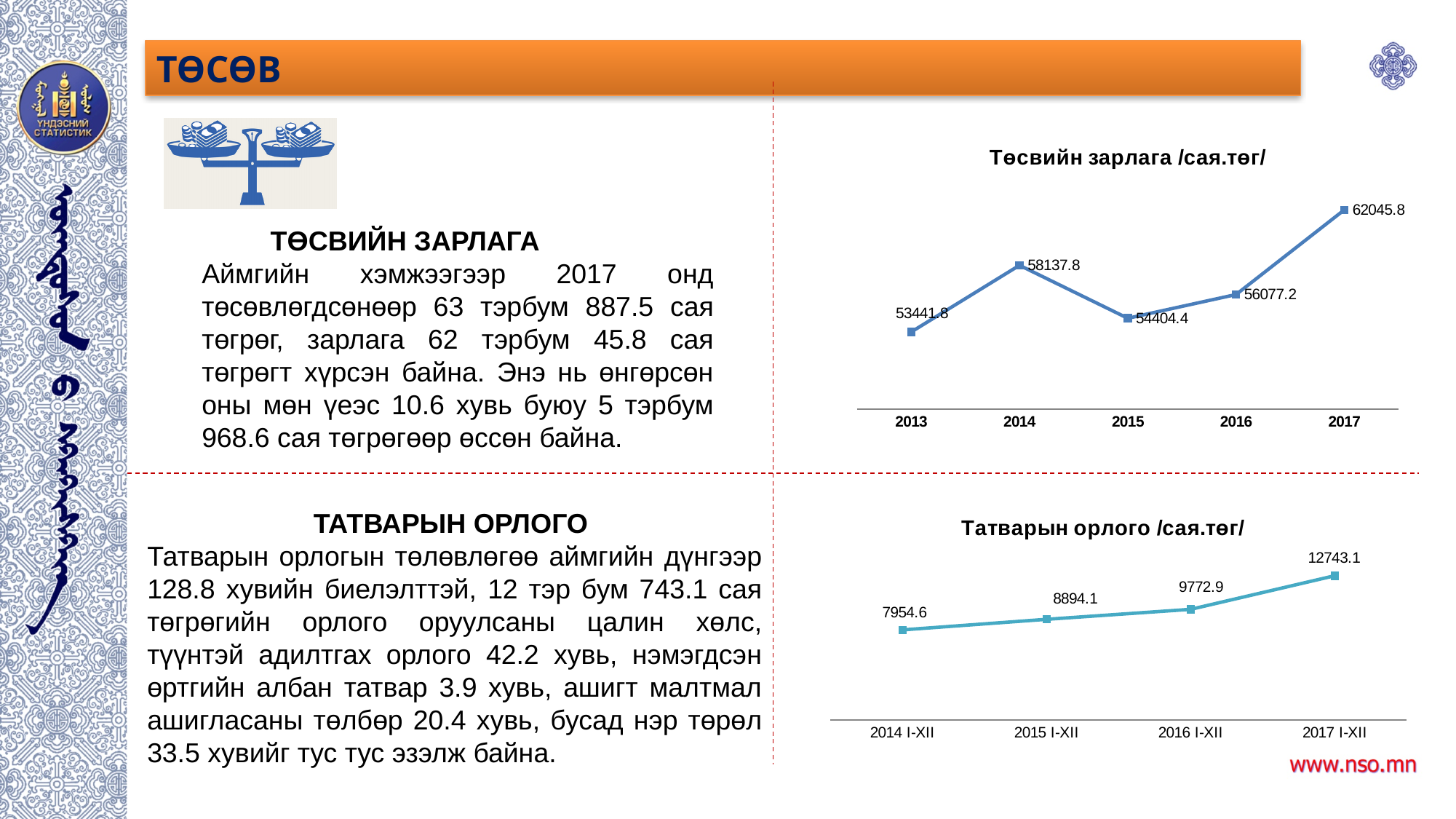
In the chart titled 'Татварын орлого /сая.төг/', what is the difference between the 2017 I-XII and 2014 I-XII values? 4788.5 In the chart titled 'Төсвийн зарлага /сая.төг/', which year has the lowest value? 2013 In the chart titled 'Төсвийн зарлага /сая.төг/', what is the difference between the 2017 and 2013 values? 8604.0 In the chart titled 'Төсвийн зарлага /сая.төг/', what is the value for 2014? 58137.8 In the chart titled 'Татварын орлого /сая.төг/', do the values rise or fall from 2014 I-XII to 2017 I-XII? rise In the chart titled 'Төсвийн зарлага /сая.төг/', which year has the highest value? 2017 In the chart titled 'Татварын орлого /сая.төг/', what is the value for 2016 I-XII? 9772.9 What kind of chart is the chart titled 'Татварын орлого /сая.төг/'? line chart In the chart titled 'Төсвийн зарлага /сая.төг/', which is larger, the value for 2014 or the value for 2015? 2014 In the chart titled 'Төсвийн зарлага /сая.төг/', how many years are plotted? 5 In the chart titled 'Татварын орлого /сая.төг/', what is the value for 2014 I-XII? 7954.6 In the chart titled 'Төсвийн зарлага /сая.төг/', what is the value for 2017? 62045.8